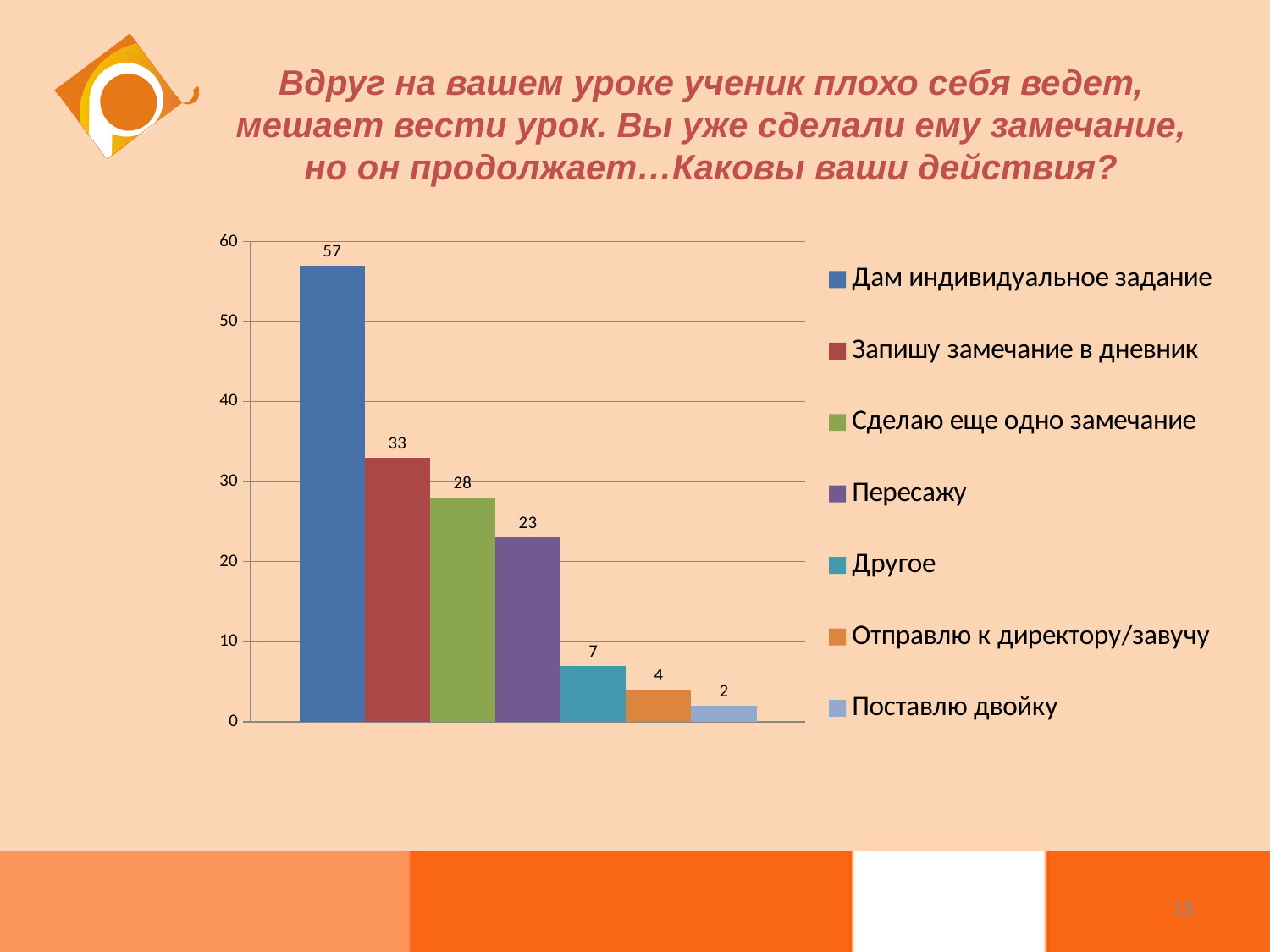
Is the value for "Другое" greater or less than 10? less What is the value for "Дам индивидуальное задание"? 57 Which category has the lowest value? Поставлю двойку Which is larger: the value for "Сделаю еще одно замечание" or the value for "Пересажу"? Сделаю еще одно замечание What kind of chart is shown on the slide? bar chart How many categories are shown in the chart? 7 What is the value for "Пересажу"? 23 What is the difference between the values for "Дам индивидуальное задание" and "Запишу замечание в дневник"? 24 Which category has the highest value? Дам индивидуальное задание What is the value for "Поставлю двойку"? 2 What colour is the bar for "Отправлю к директору/завучу"? orange What is the value for "Запишу замечание в дневник"? 33